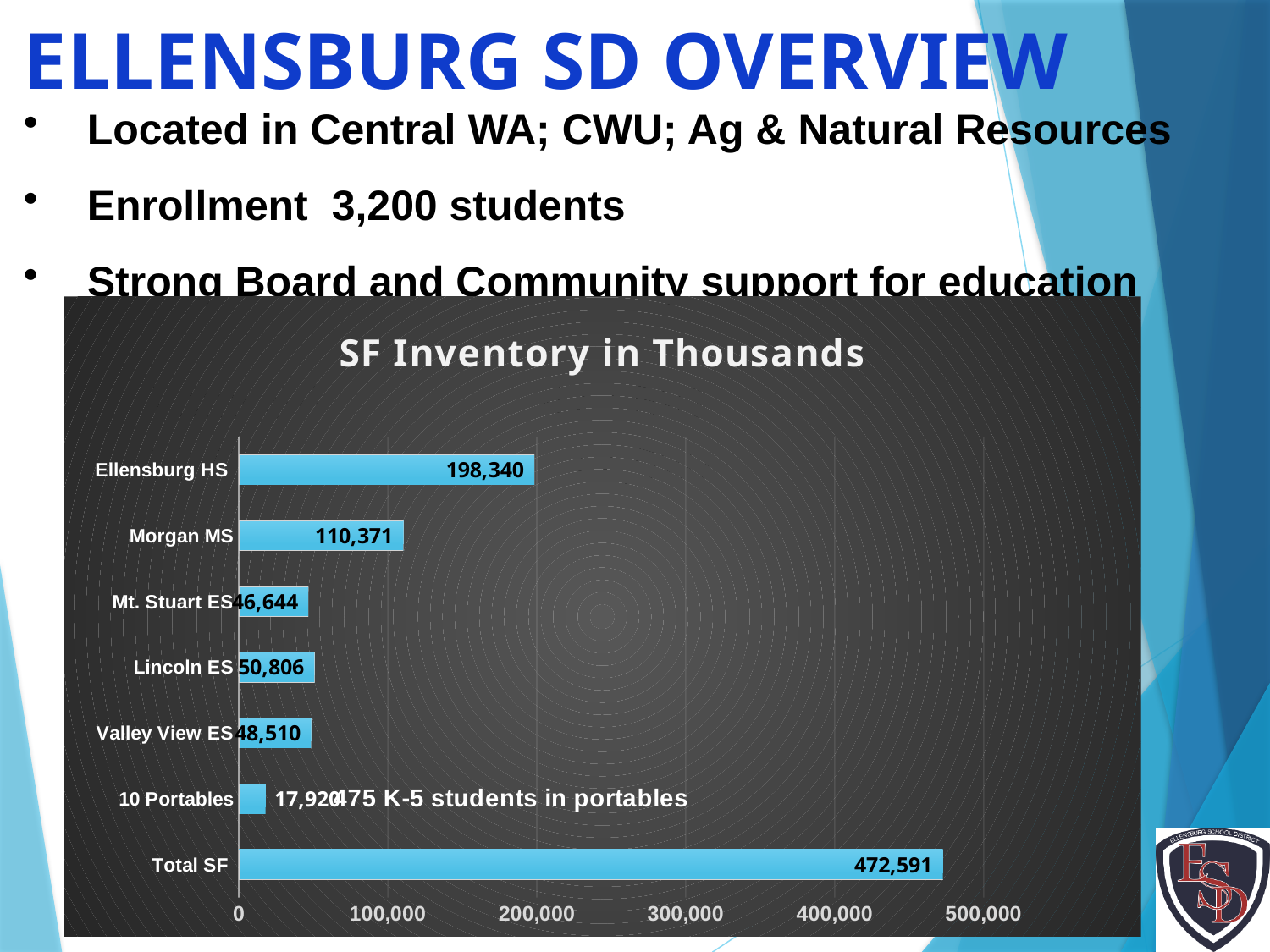
What is the value for Lincoln ES? 50,806 What is the value for Ellensburg HS in the SF Inventory in Thousands chart? 198,340 Which individual school has the largest square footage in the chart? Ellensburg HS What is the difference between the values for Ellensburg HS and Morgan MS? 87,969 What is the value for Mt. Stuart ES? 46,644 What type of chart is shown on the slide? Bar chart Which is larger, the value for Lincoln ES or the value for Valley View ES? Lincoln ES What is the value shown for Total SF? 472,591 How many categories are plotted in the chart? 7 Which category has the smallest bar in the chart? 10 Portables Is the value for Morgan MS greater or less than 100,000? greater What is the value for Morgan MS? 110,371